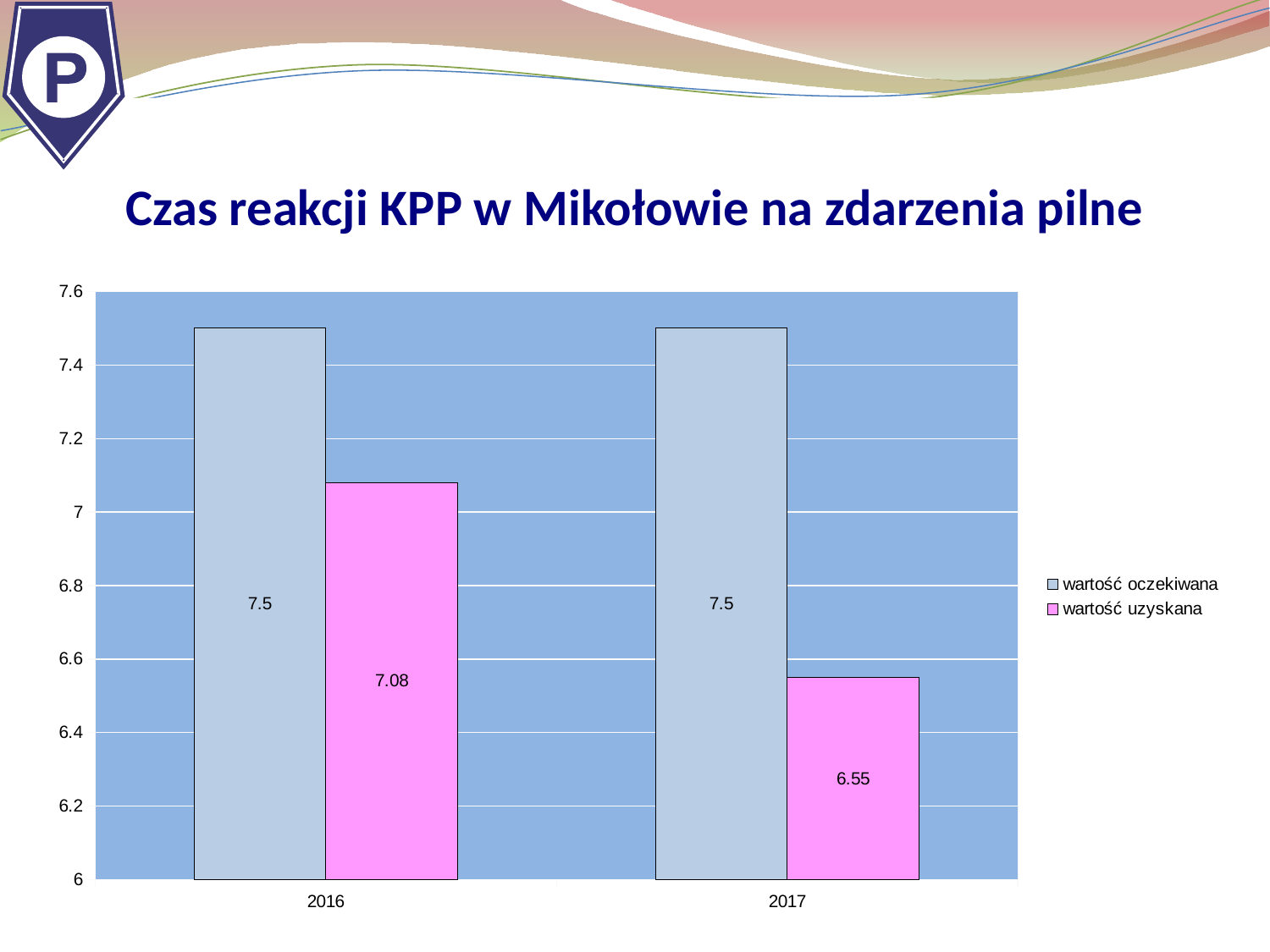
Does the 'wartość uzyskana' value rise or fall from 2016 to 2017? fall What is the difference between the 'wartość uzyskana' values for 2016 and 2017? 0.53 What is the value of 'wartość oczekiwana' for 2017? 7.5 Is the 'wartość uzyskana' value for 2017 greater or less than 6.6? less How many series does the legend list? 2 How many years are shown on the x axis? 2 What is the value of 'wartość uzyskana' for 2017? 6.55 What is the difference between 'wartość oczekiwana' and 'wartość uzyskana' in 2017? 0.95 Which is larger in 2016: 'wartość oczekiwana' or 'wartość uzyskana'? wartość oczekiwana What kind of chart is shown on the slide? bar chart Which year has the lower 'wartość uzyskana' value? 2017 What is the value of 'wartość uzyskana' for 2016? 7.08